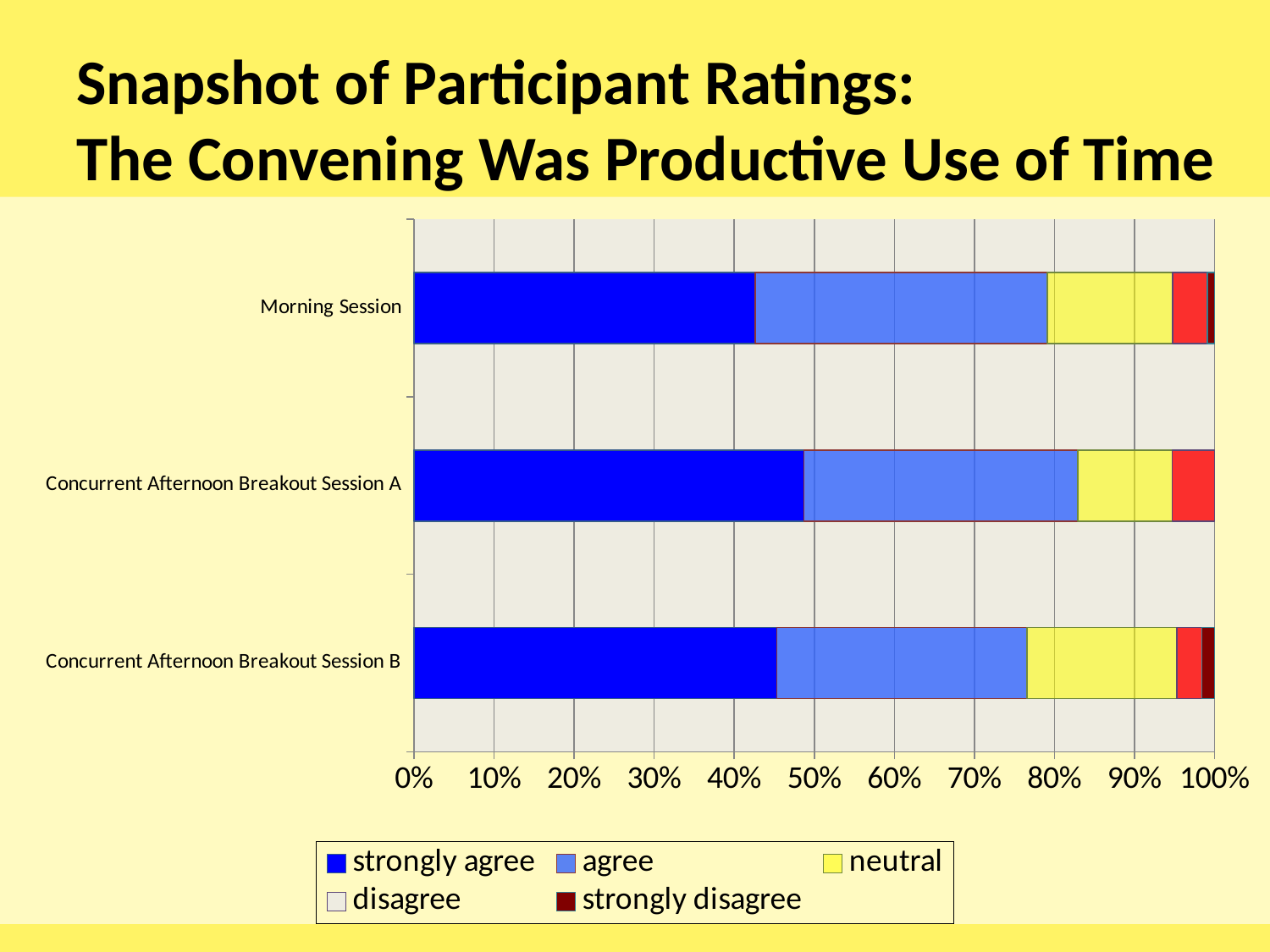
Which session has the largest 'neutral' segment? Concurrent Afternoon Breakout Session B How many sessions (categories) are plotted in the chart? 3 Which session has the smallest 'strongly agree' segment? Morning Session Is the 'strongly agree' share for the Morning Session greater or less than 40%? greater Is the 'strongly agree' share for Concurrent Afternoon Breakout Session A greater or less than 40%? greater Which has a larger 'strongly agree' segment: the Morning Session or Concurrent Afternoon Breakout Session A? Concurrent Afternoon Breakout Session A What kind of chart is shown on the slide? Stacked bar chart How many series does the legend list? 5 What is the title of the slide containing the chart? Snapshot of Participant Ratings: The Convening Was Productive Use of Time Which legend entry is shown in dark blue? strongly agree Is the 'strongly agree' share for Concurrent Afternoon Breakout Session B greater or less than 50%? less Which session has the largest 'strongly agree' segment? Concurrent Afternoon Breakout Session A